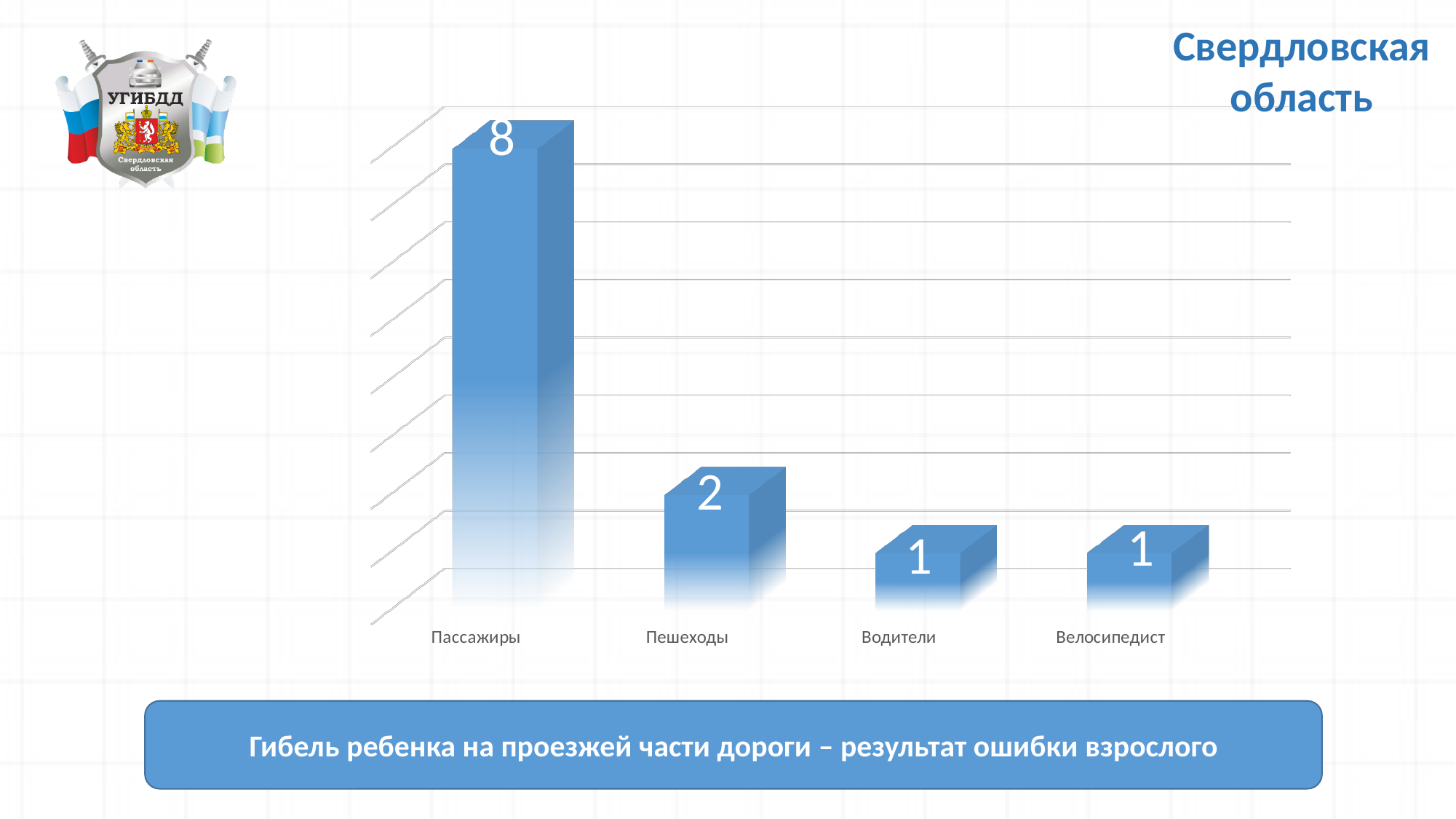
What is the value for Пассажиры? 8 Which is larger, the value for Пешеходы or the value for Водители? Пешеходы What is the value for Пешеходы? 2 What is the difference between the values for Пешеходы and Велосипедист? 1 What is the value for Велосипедист? 1 What kind of chart is shown on the slide? bar chart What colour are the bars in the chart? blue What is the difference between the values for Пассажиры and Пешеходы? 6 What is the value for Водители? 1 How many categories are shown on the x axis? 4 Do the values rise or fall from Пассажиры to Водители along the x axis? fall Which category has the highest value? Пассажиры